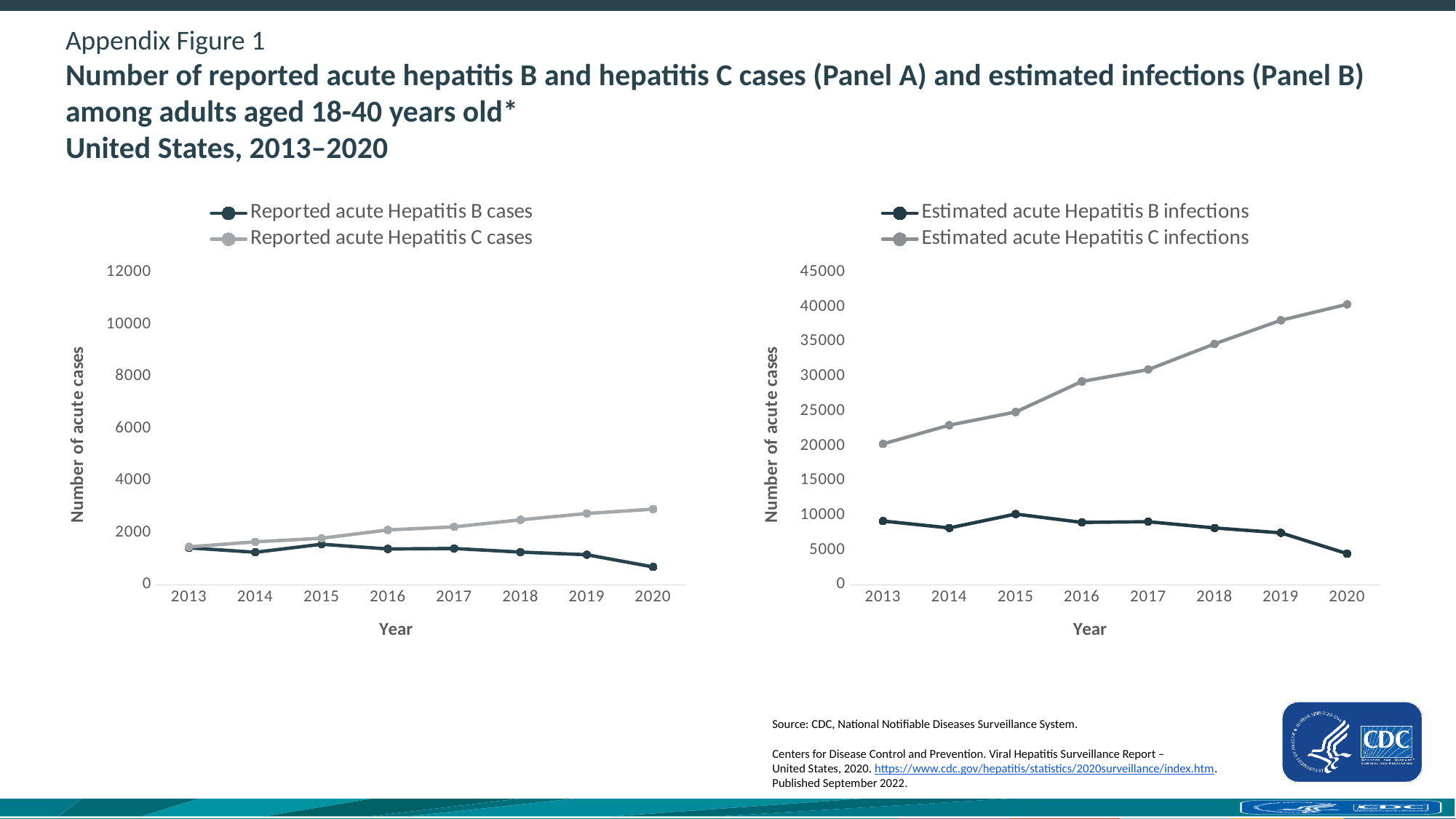
In the right chart (Panel B, estimated infections), which series has the larger value in 2020: estimated acute Hepatitis B infections or estimated acute Hepatitis C infections? Estimated acute Hepatitis C infections In the left chart (Panel A, reported cases), is the value for reported acute Hepatitis C cases in 2020 greater or less than 2000? greater In the right chart (Panel B, estimated infections), is the value for estimated acute Hepatitis C infections in 2020 greater or less than 35000? greater In the right chart (Panel B, estimated infections), how many series does the legend list? 2 In the right chart (Panel B, estimated infections), which year has the highest estimated acute Hepatitis C infections? 2020 In the right chart (Panel B, estimated infections), is the value for estimated acute Hepatitis C infections in 2013 greater or less than 25000? less In the right chart (Panel B, estimated infections), do the estimated acute Hepatitis C infections rise or fall from 2013 to 2020? rise What kind of chart is the left chart (Panel A, reported acute hepatitis cases)? line chart In the left chart (Panel A, reported cases), which year has the lowest reported acute Hepatitis B cases? 2020 In the left chart (Panel A, reported cases), how many years are shown on the x axis? 8